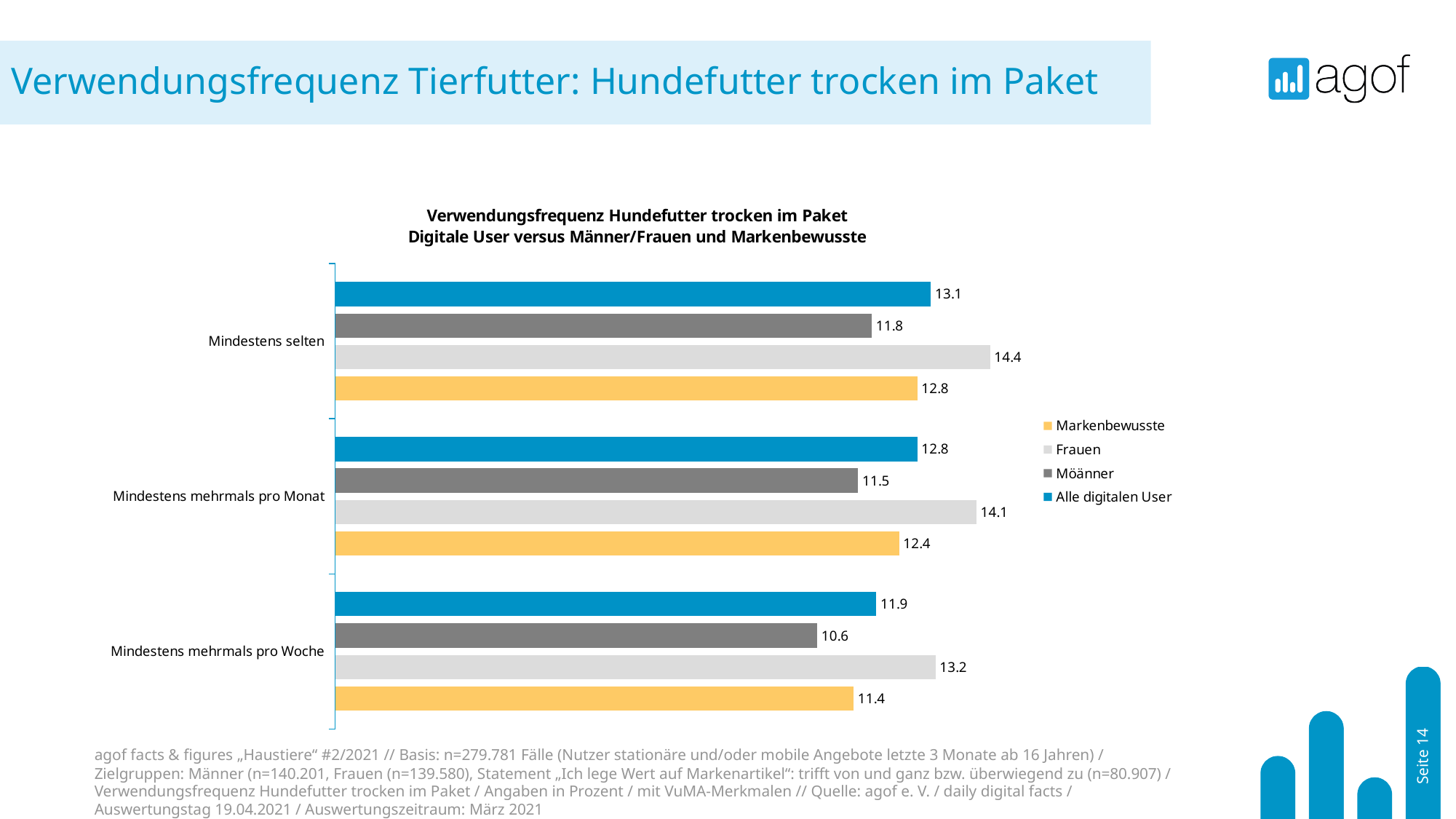
How many series does the legend list? 4 Which colour represents the Markenbewusste series? Yellow What is the value for Möänner in the 'Mindestens mehrmals pro Woche' category? 10.6 Which series has the highest value in the 'Mindestens mehrmals pro Monat' category? Frauen What kind of chart is shown on the slide? Bar chart What is the difference between the Frauen and Möänner values in the 'Mindestens mehrmals pro Woche' category? 2.6 What is the value for Markenbewusste in the 'Mindestens mehrmals pro Monat' category? 12.4 How many categories are shown on the chart? 3 What is the value for Frauen in the 'Mindestens selten' category? 14.4 What is the value for Alle digitalen User in the 'Mindestens mehrmals pro Woche' category? 11.9 Which series has the lowest value in the 'Mindestens selten' category? Möänner Which is larger: the Alle digitalen User value for 'Mindestens selten' or for 'Mindestens mehrmals pro Monat'? Mindestens selten